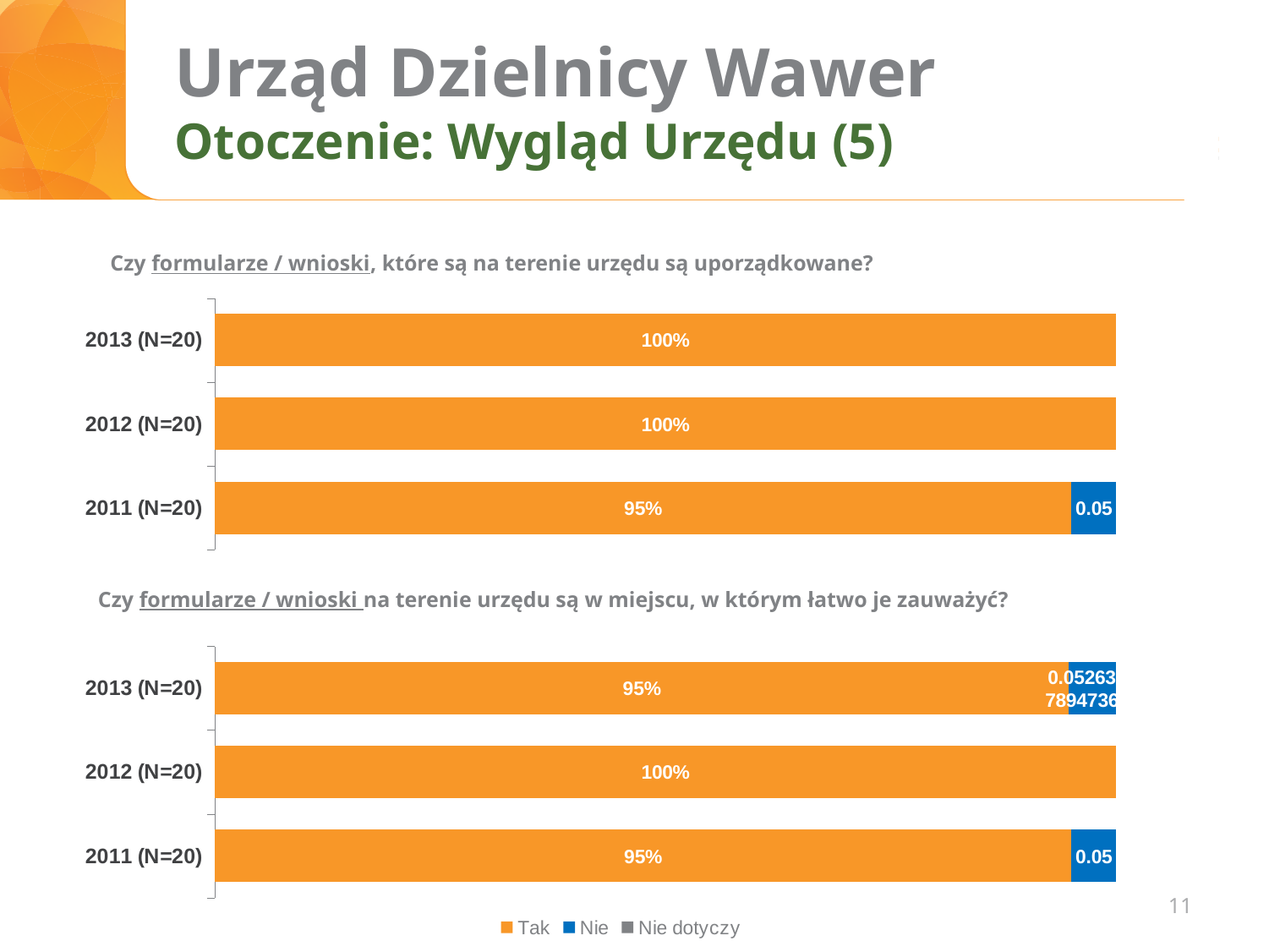
In the top chart ("Czy formularze / wnioski, które są na terenie urzędu są uporządkowane?"), what is the "Tak" value for 2011 (N=20)? 95% In the top chart ("Czy formularze / wnioski, które są na terenie urzędu są uporządkowane?"), what is the "Tak" value for 2013 (N=20)? 100% In the top chart ("Czy formularze / wnioski, które są na terenie urzędu są uporządkowane?"), what is the difference between the "Tak" values for 2012 (N=20) and 2011 (N=20)? 5% In the top chart ("Czy formularze / wnioski, które są na terenie urzędu są uporządkowane?"), which year has the lowest "Tak" value? 2011 (N=20) In the bottom chart ("Czy formularze / wnioski na terenie urzędu są w miejscu, w którym łatwo je zauważyć?"), what is the "Tak" value for 2012 (N=20)? 100% In the top chart ("Czy formularze / wnioski, które są na terenie urzędu są uporządkowane?"), what is the "Nie" value labelled for 2011 (N=20)? 0.05 How many series does the legend at the bottom of the slide list? 3 How many year categories does the top chart ("Czy formularze / wnioski, które są na terenie urzędu są uporządkowane?") show? 3 In the bottom chart ("Czy formularze / wnioski na terenie urzędu są w miejscu, w którym łatwo je zauważyć?"), what is the "Tak" value for 2013 (N=20)? 95% In the bottom chart ("Czy formularze / wnioski na terenie urzędu są w miejscu, w którym łatwo je zauważyć?"), is the "Tak" value for 2012 (N=20) larger or smaller than for 2011 (N=20)? larger In the bottom chart ("Czy formularze / wnioski na terenie urzędu są w miejscu, w którym łatwo je zauważyć?"), which year has the highest "Tak" value? 2012 (N=20) What type of chart is the bottom chart ("Czy formularze / wnioski na terenie urzędu są w miejscu, w którym łatwo je zauważyć?")? Stacked horizontal bar chart